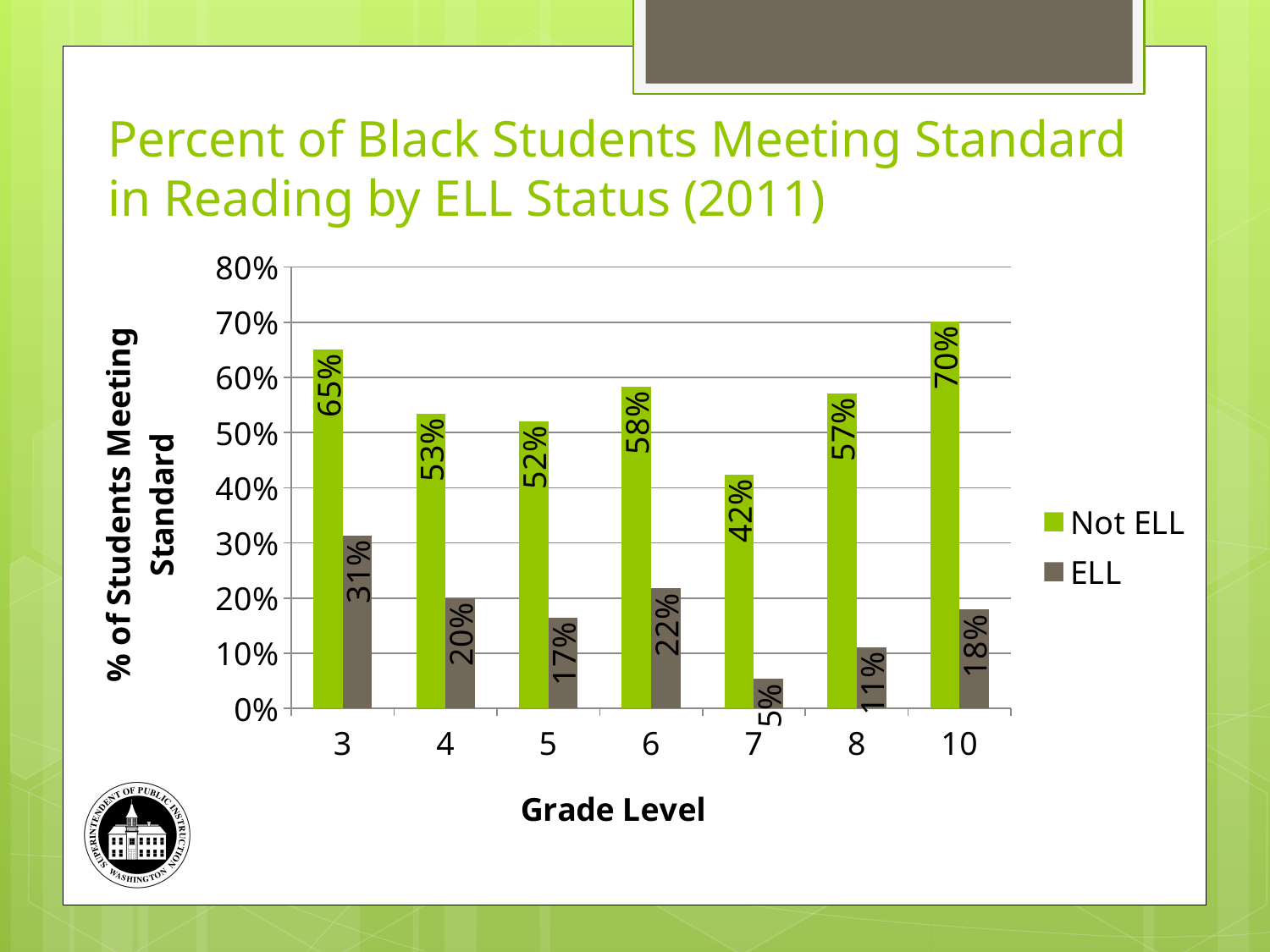
What kind of chart is shown on the slide? Bar chart Which grade level has the lowest value for ELL students? 7 What percent of ELL Black students met the reading standard in grade 7? 5% What is the value for ELL students in grade 10? 18% What is the difference between the Not ELL and ELL values in grade 6? 36% Which grade level has the highest value for Not ELL students? 10 How many series does the legend list? 2 What percent of Not ELL Black students met the reading standard in grade 3? 65% What is the label of the x axis? Grade Level How many grade levels are shown on the x axis? 7 Which is larger, the ELL value for grade 3 or the ELL value for grade 4? Grade 3 Is the Not ELL value for grade 7 greater or less than 50%? less